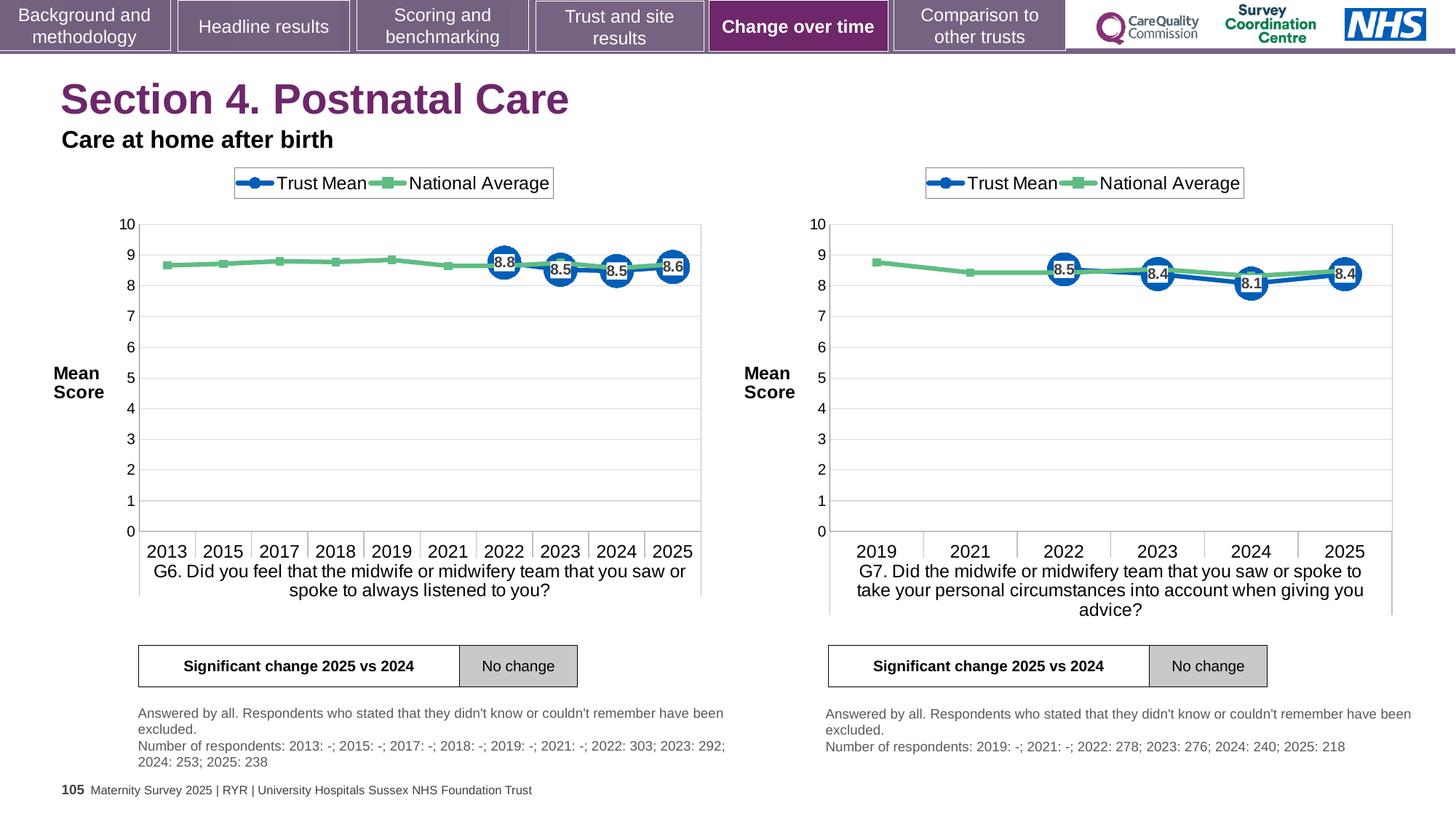
How many years are shown on the x axis of the left chart (G6)? 10 In the right chart (G7), what is the difference between the Trust Mean in 2025 and in 2024? 0.3 In the left chart (G6), which year has the highest Trust Mean? 2022 In the left chart (G6), is the National Average value for 2019 greater or less than 8? greater In the left chart (G6), what is the Trust Mean value for 2022? 8.8 In the left chart (G6), what is the Trust Mean value for 2025? 8.6 In the left chart (G6), what is the difference between the Trust Mean in 2022 and in 2023? 0.3 In the right chart (G7), what is the Trust Mean value for 2024? 8.1 How many series does the legend of the right chart (G7) list? 2 In the right chart (G7), what is the Trust Mean value for 2022? 8.5 In the right chart (G7), which year has the lowest Trust Mean? 2024 What kind of chart is the left chart (G6)? Line chart